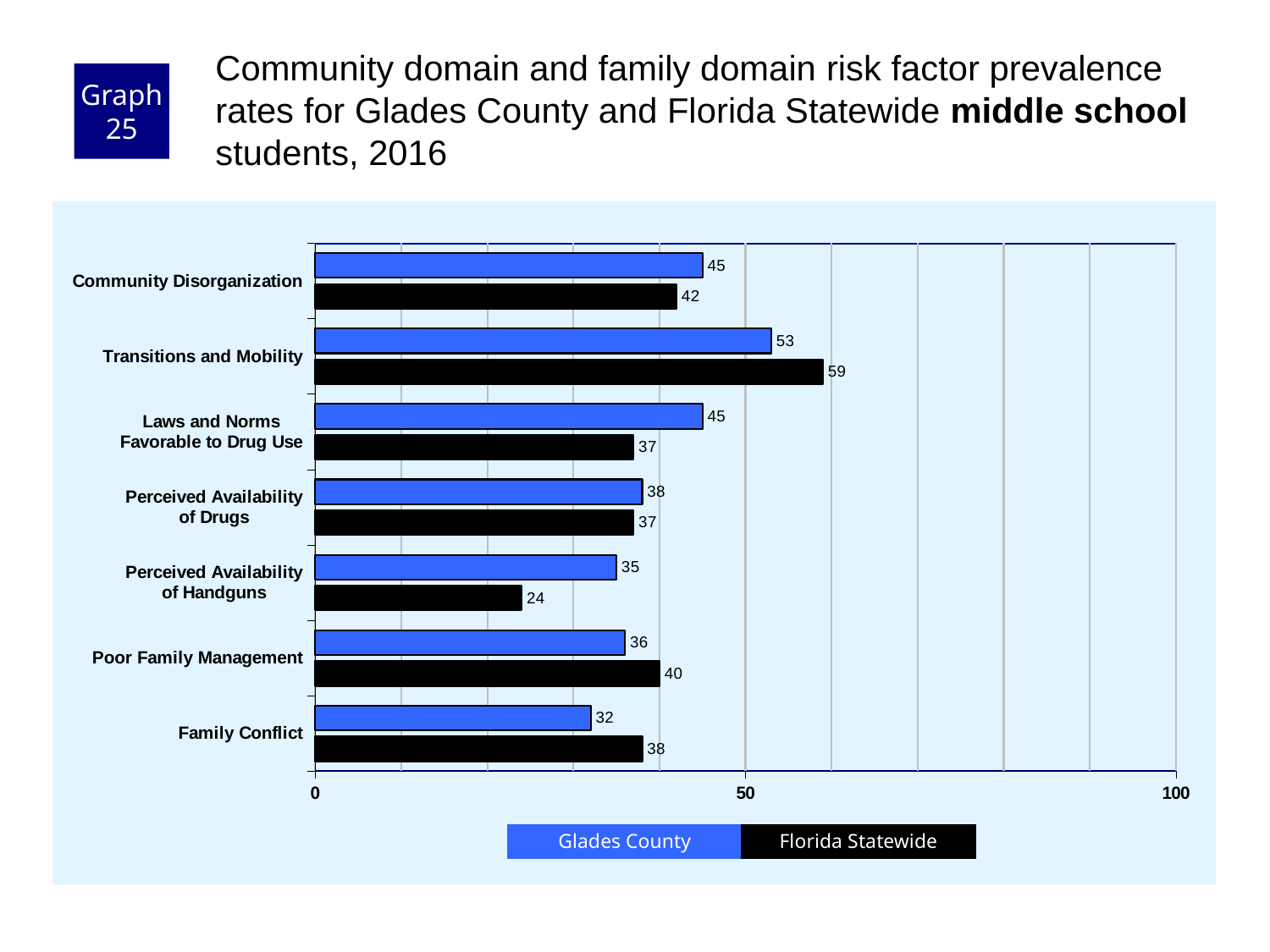
How many series does the legend list? 2 What kind of chart is shown on the slide? Bar chart For Laws and Norms Favorable to Drug Use, which is larger: the Glades County value or the Florida Statewide value? Glades County What is the difference between the Glades County and Florida Statewide values for Perceived Availability of Handguns? 11 Which colour represents Florida Statewide in the chart? Black Is the Florida Statewide value for Transitions and Mobility greater or less than 50? greater What is the Glades County value for Transitions and Mobility? 53 Which risk factor has the highest Florida Statewide value? Transitions and Mobility What is the Florida Statewide value for Perceived Availability of Handguns? 24 Which risk factor has the lowest Glades County value? Family Conflict What is the Florida Statewide value for Family Conflict? 38 How many risk factors are shown on the chart? 7